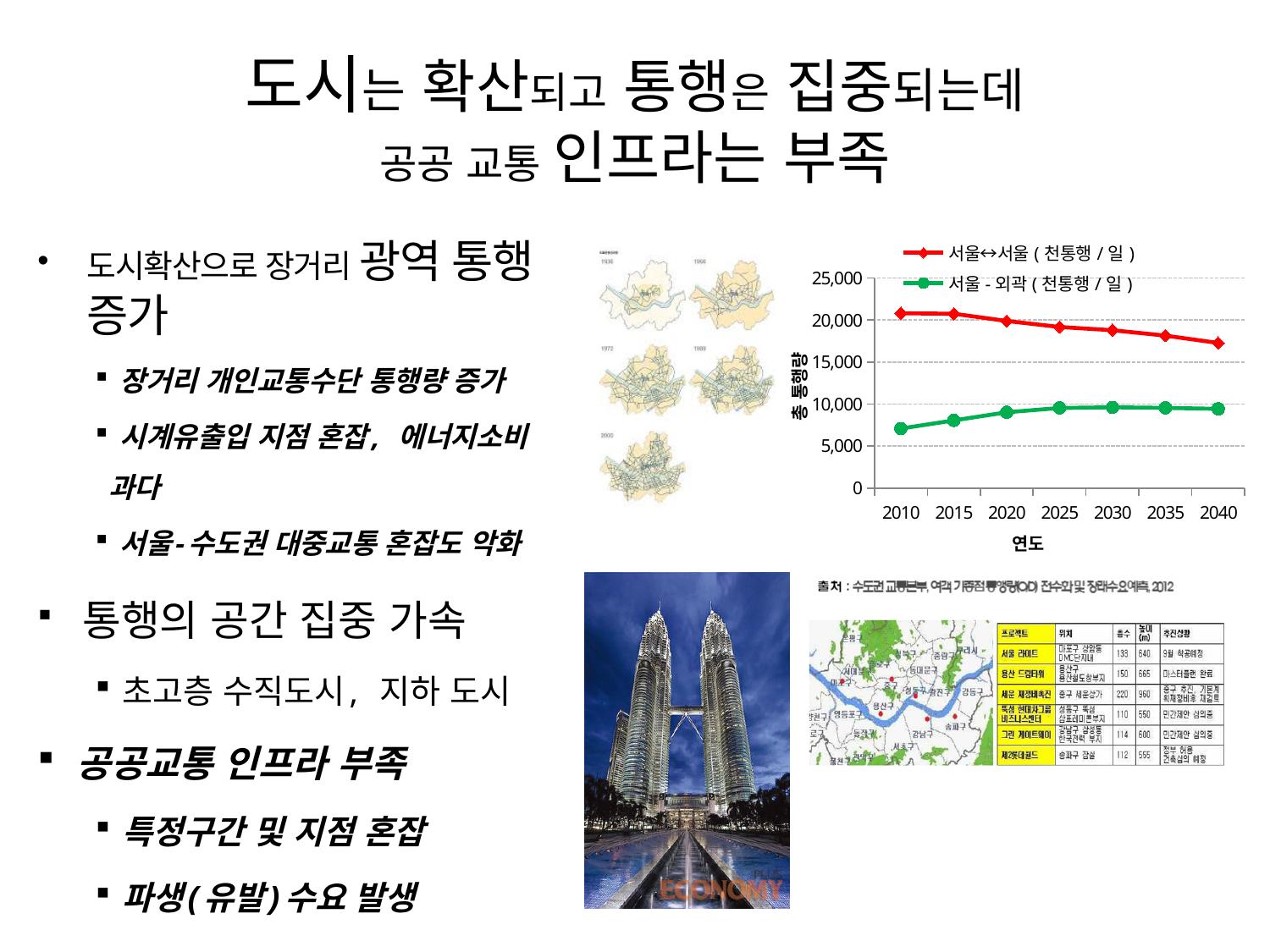
Is the value for 서울-외곽 in 2010 greater or less than 5,000? greater In which year is the 서울↔서울 series at its lowest? 2040 Is the value for 서울↔서울 in 2010 greater or less than 20,000? greater Does the 서울-외곽 series rise or fall from 2010 to 2020? rise How many series does the chart's legend list? 2 In 2010, which series has the larger value, 서울↔서울 or 서울-외곽? 서울↔서울 Does the 서울↔서울 series rise or fall from 2010 to 2040? fall Is the value for 서울-외곽 in 2010 greater or less than 10,000? less What kind of chart is shown on the slide? line chart What is the label of the chart's x axis? 연도 How many years are plotted along the x axis of the chart? 7